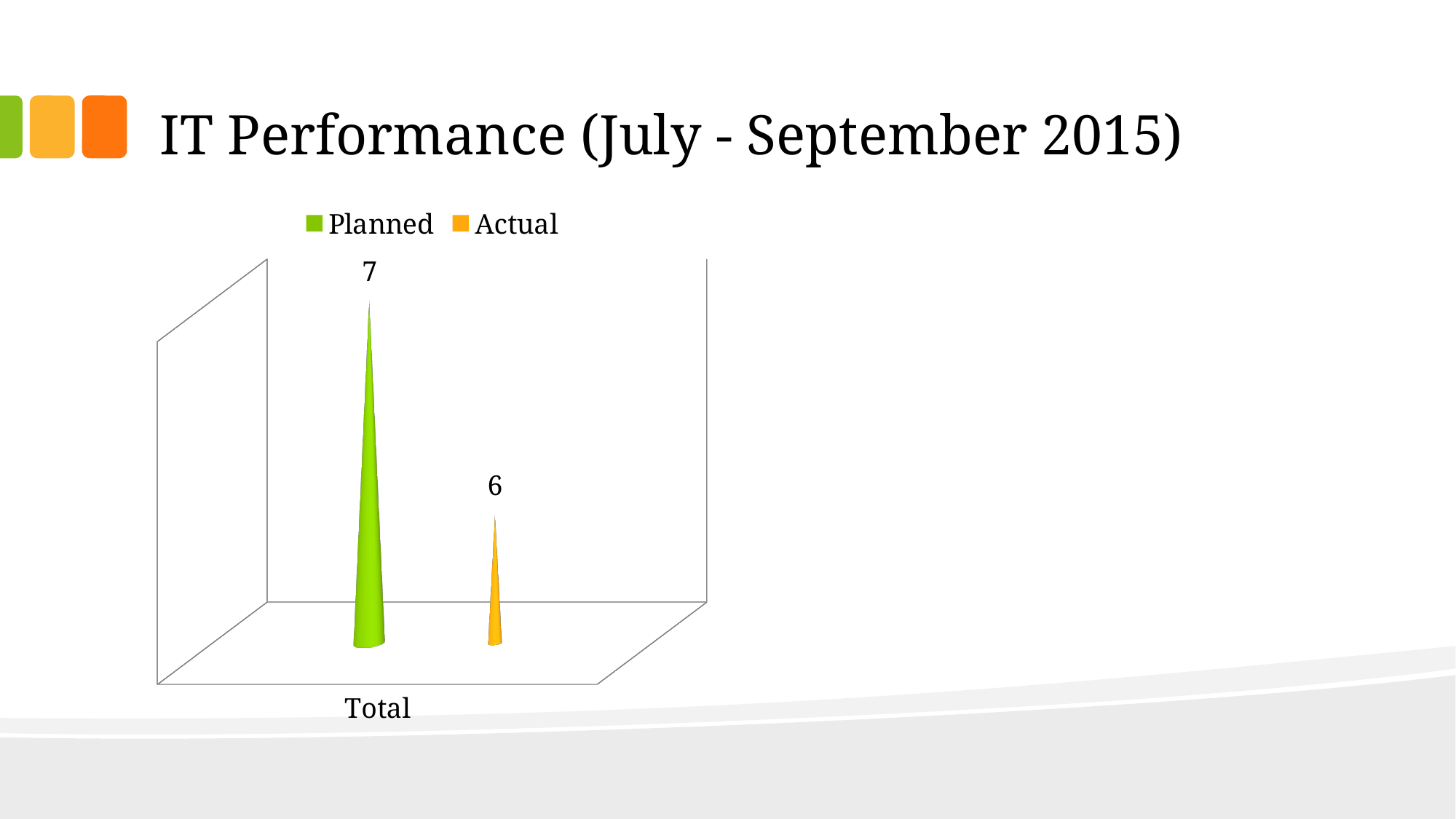
How many categories are shown on the x axis? 1 What is the label of the category on the x axis? Total What is the Planned value for Total? 7 What kind of chart is shown on the slide? Bar chart What is the difference between the Planned and Actual values for Total? 1 What colour represents the Actual series in the chart? Orange What is the title of the slide containing the chart? IT Performance (July - September 2015) Which series has the higher value for Total, Planned or Actual? Planned What is the Actual value for Total? 6 How many series does the legend list? 2